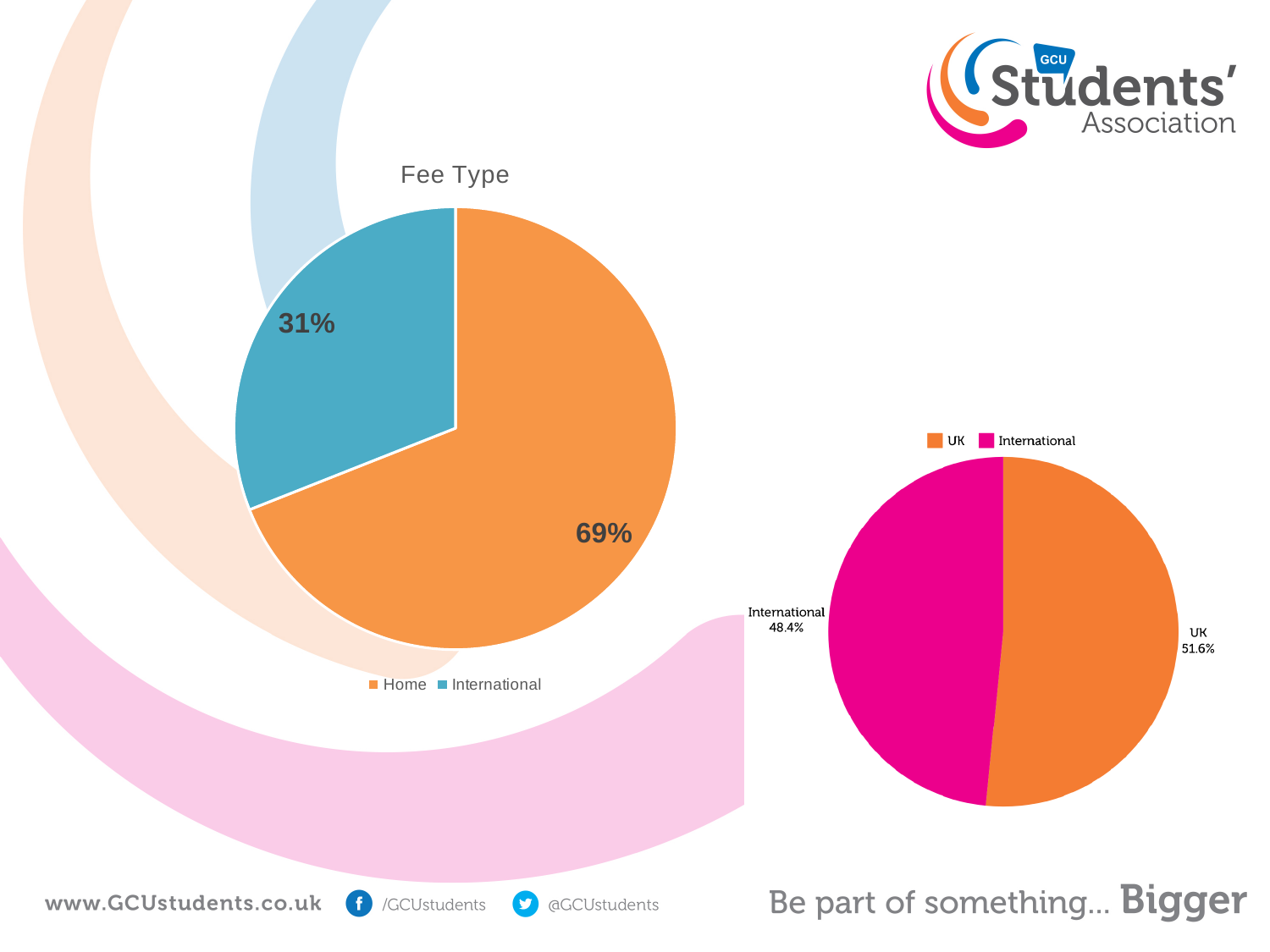
In the pie chart on the right of the slide, what percentage is labelled for UK? 51.6% In the 'Fee Type' pie chart on the left, what share is labelled for International? 31% What is the title of the pie chart on the left of the slide? Fee Type In the pie chart on the right of the slide, what percentage is labelled for International? 48.4% In the 'Fee Type' pie chart on the left, what share is labelled for Home? 69% In the 'Fee Type' pie chart on the left, which category has the largest slice? Home What type of chart is the 'Fee Type' chart on the left? Pie chart In the 'Fee Type' pie chart on the left, how many categories does the legend list? 2 In the pie chart on the right of the slide, what colour is the UK slice? Orange In the 'Fee Type' pie chart on the left, what is the difference in percentage points between Home and International? 38 In the pie chart on the right of the slide, what is the difference in percentage points between UK and International? 3.2 In the pie chart on the right of the slide, which category has the smaller slice? International